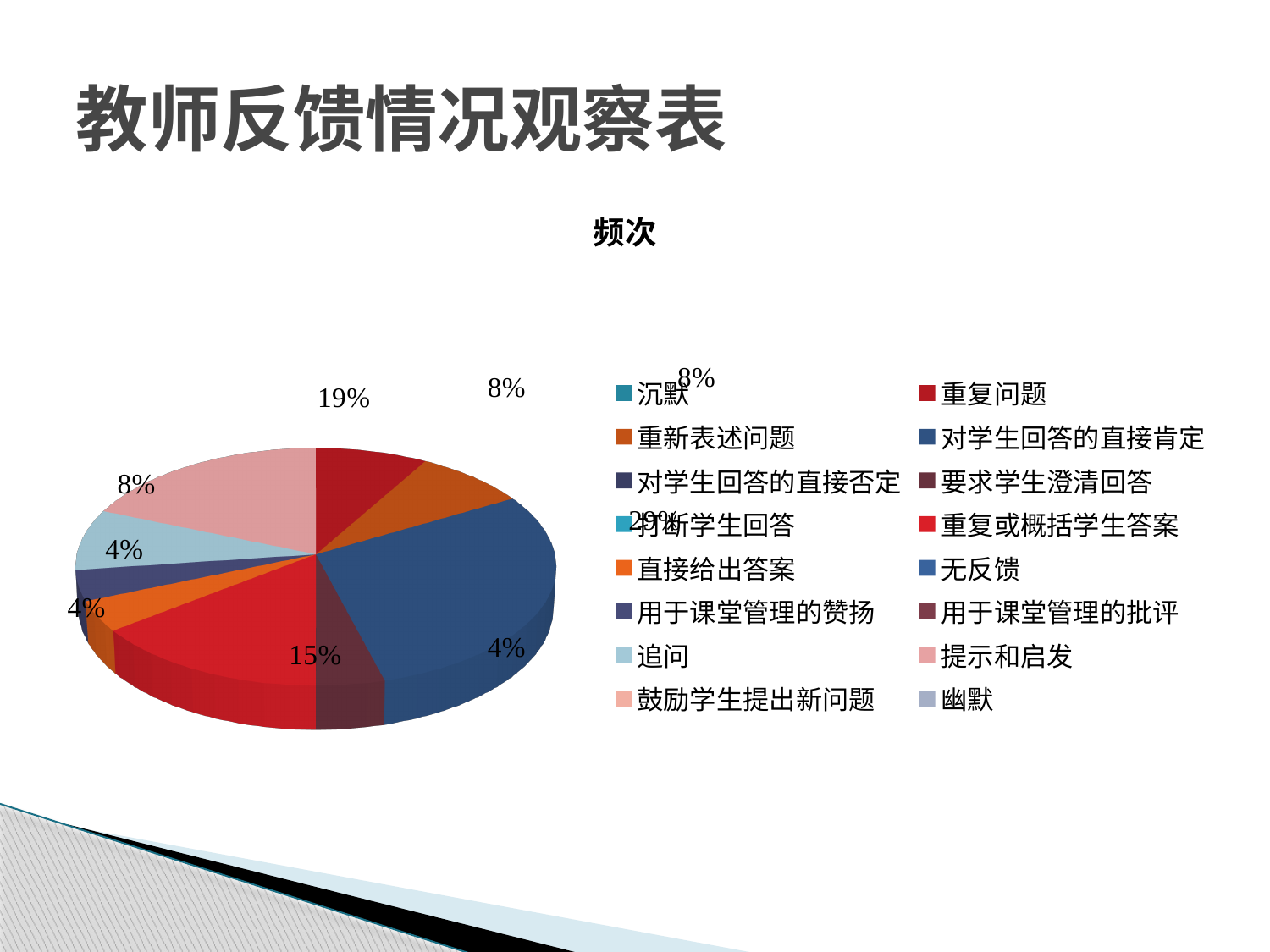
What colour is the legend marker for 无反馈? blue What share of the pie does 提示和启发 take? 19% Which is larger, the slice for 提示和启发 or the slice for 重复或概括学生答案? 提示和启发 What is the difference in percentage points between the 提示和启发 slice and the 重复或概括学生答案 slice? 4 How many entries does the chart's legend list? 16 What share of the pie does 对学生回答的直接肯定 take? 29% What kind of chart is shown on the slide? pie chart What share of the pie does 重复或概括学生答案 take? 15% What is the title of the chart? 频次 How many data labels are printed around the pie? 9 Which category has the largest slice of the pie? 对学生回答的直接肯定